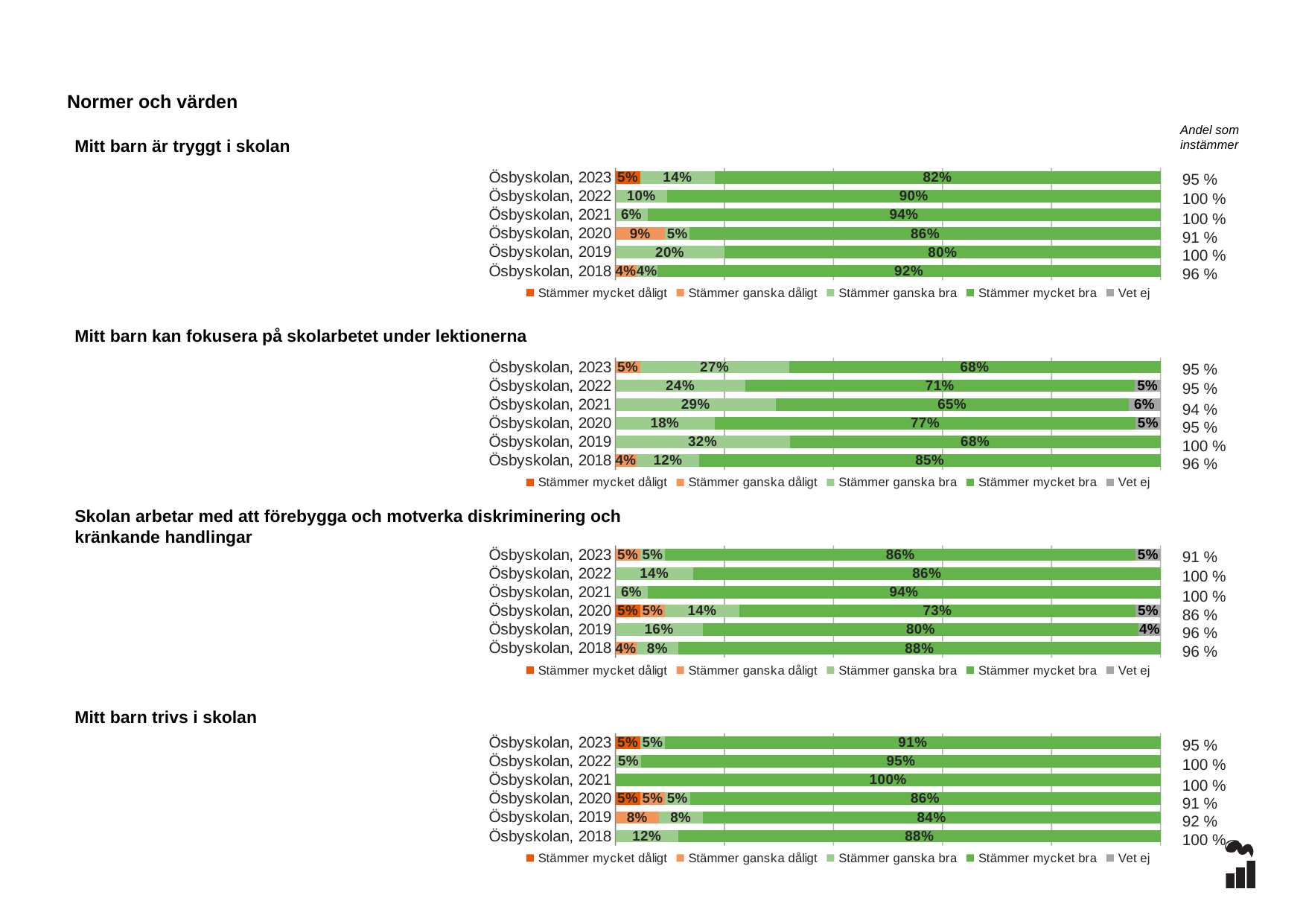
In the chart 'Skolan arbetar med att förebygga och motverka diskriminering och kränkande handlingar', which is larger: the 'Stämmer ganska bra' value for Ösbyskolan, 2019 or for Ösbyskolan, 2022? Ösbyskolan, 2019 How many bars (years) are shown in the chart 'Mitt barn trivs i skolan'? 6 In the chart 'Mitt barn trivs i skolan', what is the 'Stämmer mycket bra' value for Ösbyskolan, 2021? 100% In the chart 'Mitt barn är tryggt i skolan', which year has the lowest 'Stämmer mycket bra' value? Ösbyskolan, 2019 In the chart 'Mitt barn kan fokusera på skolarbetet under lektionerna', which year has the highest 'Stämmer mycket bra' value? Ösbyskolan, 2018 How many series does the legend of the chart 'Mitt barn är tryggt i skolan' list? 5 In the chart 'Mitt barn trivs i skolan', what is the difference between the 'Stämmer mycket bra' values for Ösbyskolan, 2022 and Ösbyskolan, 2019? 11% In the chart 'Mitt barn kan fokusera på skolarbetet under lektionerna', what is the 'Stämmer ganska bra' value for Ösbyskolan, 2019? 32% In the chart 'Mitt barn är tryggt i skolan', what is the 'Stämmer mycket bra' value for Ösbyskolan, 2021? 94% What kind of chart is 'Mitt barn är tryggt i skolan'? Stacked bar chart In the chart 'Mitt barn kan fokusera på skolarbetet under lektionerna', what is the difference between the 'Stämmer mycket bra' values for Ösbyskolan, 2020 and Ösbyskolan, 2021? 12% In the chart 'Skolan arbetar med att förebygga och motverka diskriminering och kränkande handlingar', what is the 'Stämmer mycket bra' value for Ösbyskolan, 2020? 73%